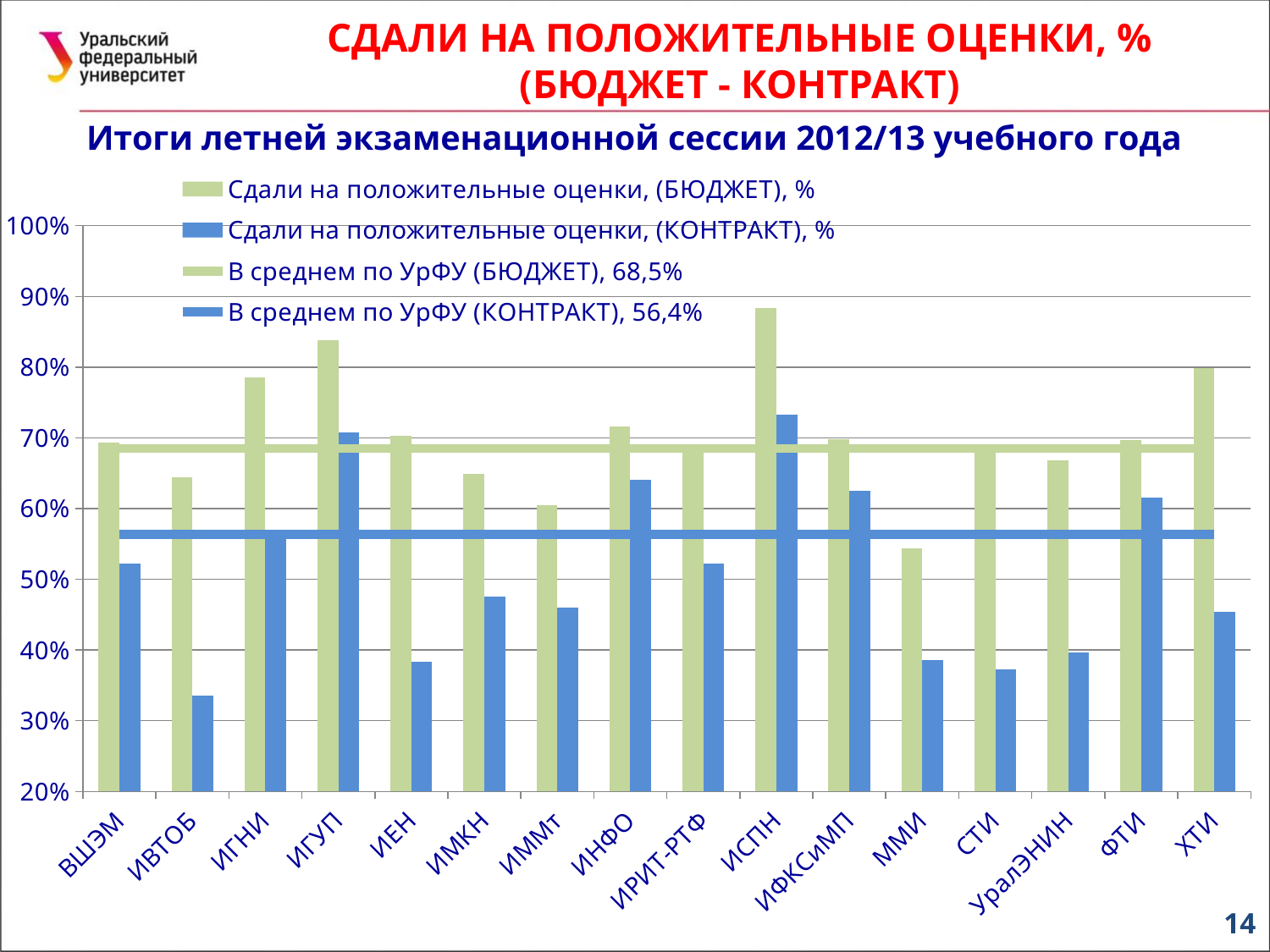
What kind of chart is shown on the slide? bar chart Is the budget value for ММИ greater or less than 60%? less Which institute has the lowest share of budget students passing with positive grades? ММИ What is the UrFU average for contract students (В среднем по УрФУ (КОНТРАКТ)) shown in the legend? 56,4% How many institutes (categories) are shown along the x axis? 16 Is the budget value for ИСПН greater or less than 80%? greater Which institute has the lowest share of contract students passing with positive grades? ИВТОБ How many entries does the legend list? 4 What is the UrFU average for budget students (В среднем по УрФУ (БЮДЖЕТ)) shown in the legend? 68,5% For ИГУП, which is larger: the budget value or the contract value? budget Which institute has the highest share of budget students passing with positive grades? ИСПН Is the contract value for ИВТОБ greater or less than 40%? less